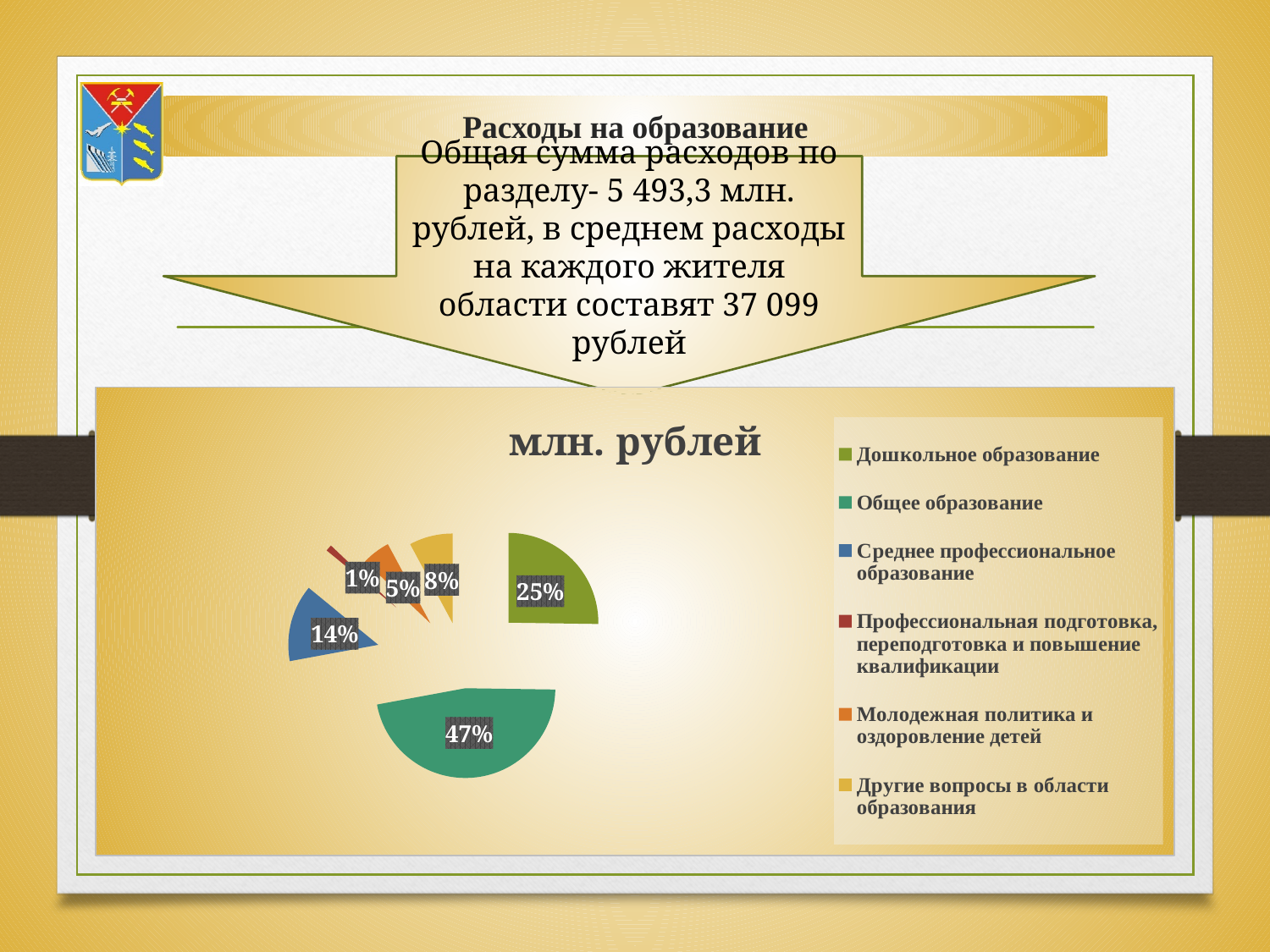
What is the chart's title? млн. рублей What share of the pie is Среднее профессиональное образование? 14% What share of the pie is Дошкольное образование? 25% What share of the pie is Другие вопросы в области образования? 8% How many categories does the legend list? 6 Which is larger, the share for Среднее профессиональное образование or the share for Другие вопросы в области образования? Среднее профессиональное образование Which category has the smallest share of the pie? Профессиональная подготовка, переподготовка и повышение квалификации What is the difference in percentage points between Общее образование and Дошкольное образование? 22 What kind of chart is shown on the slide? pie chart Which category has the largest share of the pie? Общее образование